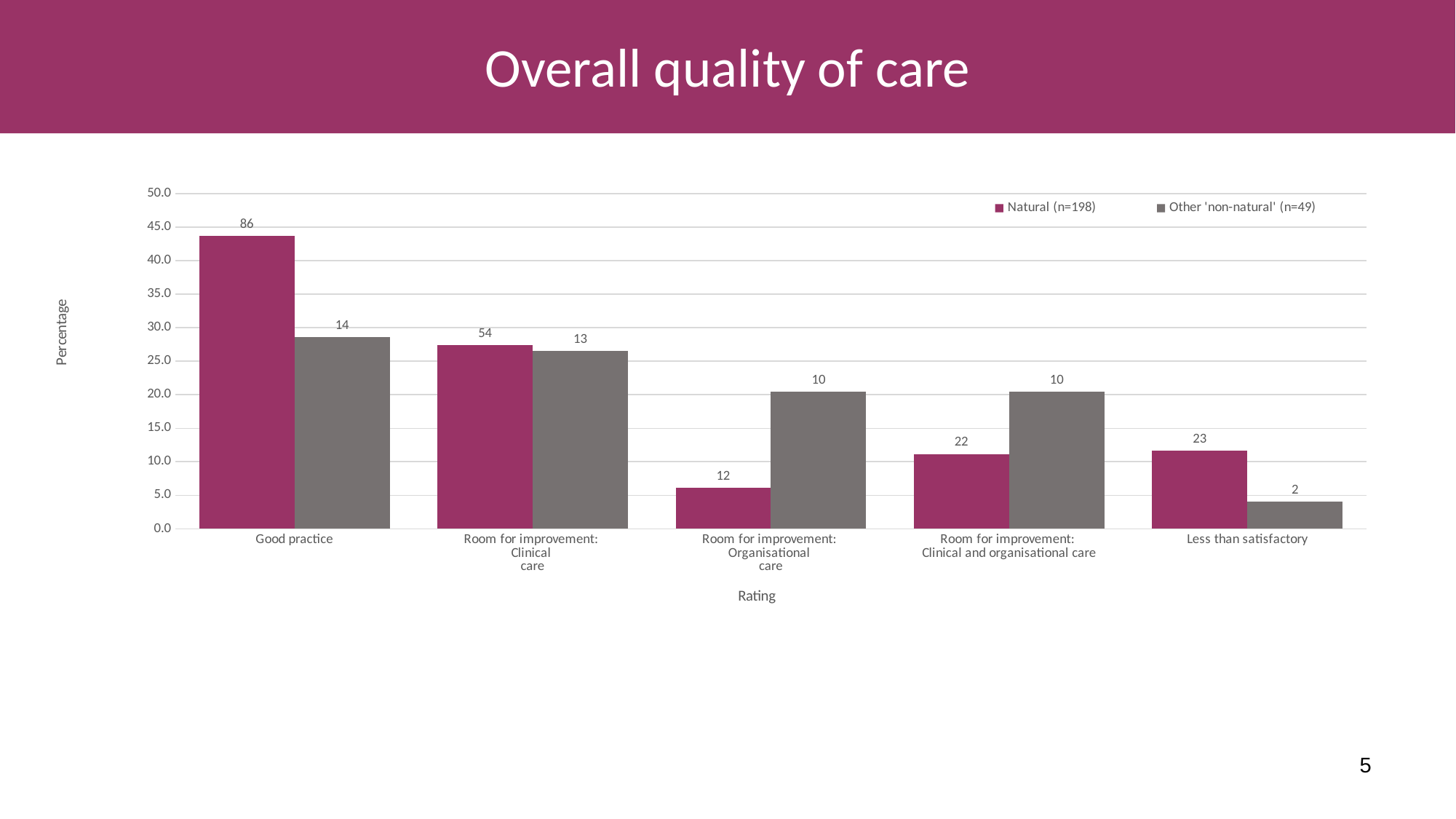
What type of chart is shown on the slide? Bar chart Is the percentage for the Other 'non-natural' (n=49) bar for Less than satisfactory greater or less than 5.0? less How many rating categories are shown on the x axis? 5 Which rating category has the shortest bar for the Other 'non-natural' (n=49) series? Less than satisfactory What data label is shown on the Natural (n=198) bar for Room for improvement: Organisational care? 12 For Room for improvement: Organisational care, which series has the taller bar, Natural (n=198) or Other 'non-natural' (n=49)? Other 'non-natural' (n=49) How many series does the legend list? 2 Is the percentage for the Natural (n=198) bar for Good practice greater or less than 40.0? greater Which rating category has the tallest bar for the Natural (n=198) series? Good practice What data label is shown on the Natural (n=198) bar for Good practice? 86 Which rating category has the shortest bar for the Natural (n=198) series? Room for improvement: Organisational care What data label is shown on the Other 'non-natural' (n=49) bar for Less than satisfactory? 2